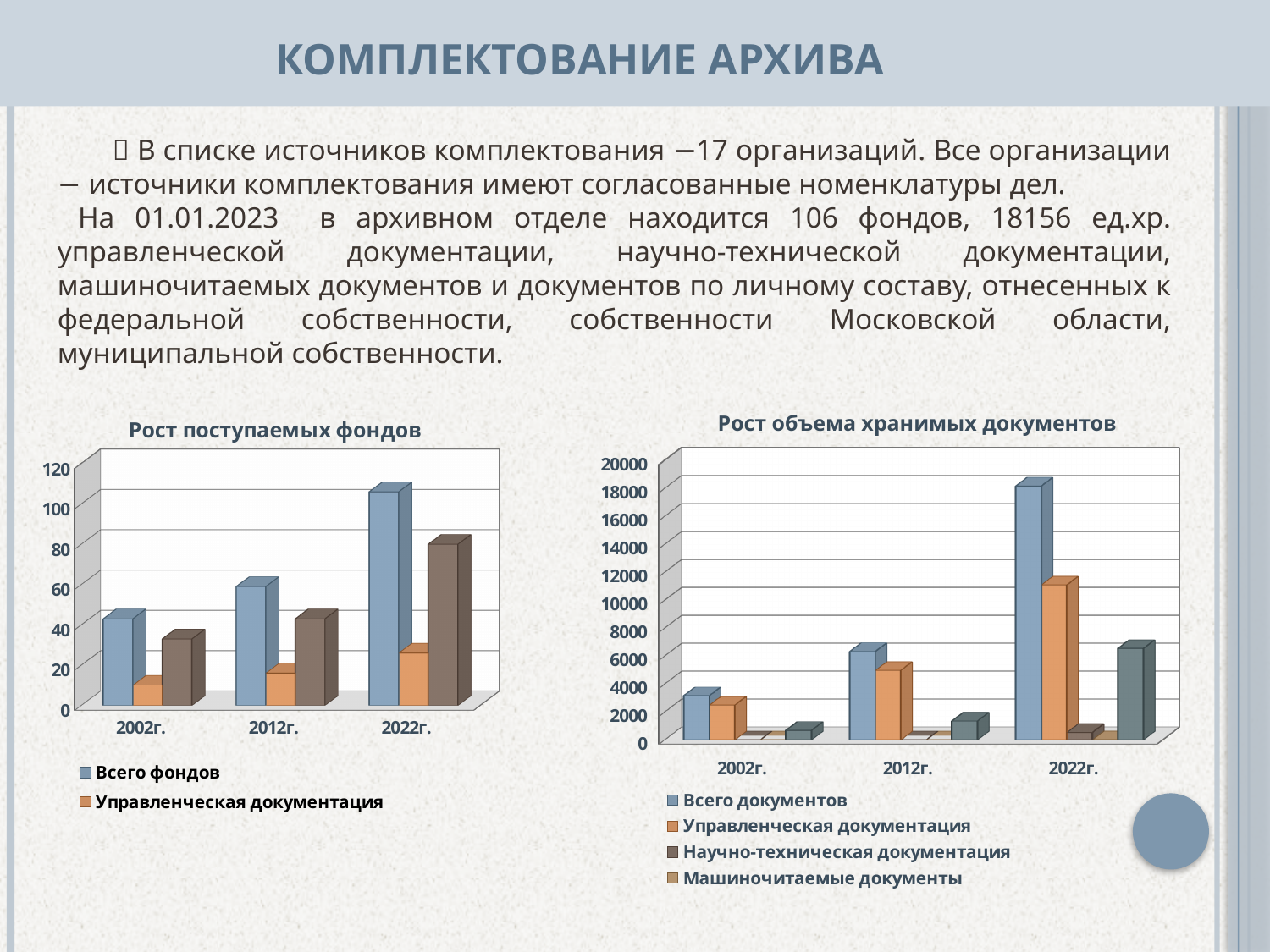
In the chart "Рост объема хранимых документов", which is larger in 2012г.: Всего документов or Управленческая документация? Всего документов What is the title of the right chart on the slide? Рост объема хранимых документов In the chart "Рост поступаемых фондов", is the value for Всего фондов in 2022г. greater or less than 80? greater In the chart "Рост объема хранимых документов", which year has the lowest value for Всего документов? 2002г. What kind of chart is the left chart titled "Рост поступаемых фондов"? bar chart In the chart "Рост объема хранимых документов", how many series does the legend list? 4 In the chart "Рост поступаемых фондов", how many year categories are shown on the x axis? 3 In the chart "Рост поступаемых фондов", do the values for Всего фондов rise or fall from 2002г. to 2022г.? rise In the chart "Рост объема хранимых документов", is the value for Всего документов in 2002г. greater or less than 4000? less In the chart "Рост объема хранимых документов", is the value for Всего документов in 2022г. greater or less than 16000? greater In the chart "Рост поступаемых фондов", how many series does the legend list? 2 In the chart "Рост поступаемых фондов", which year has the highest value for Всего фондов? 2022г.